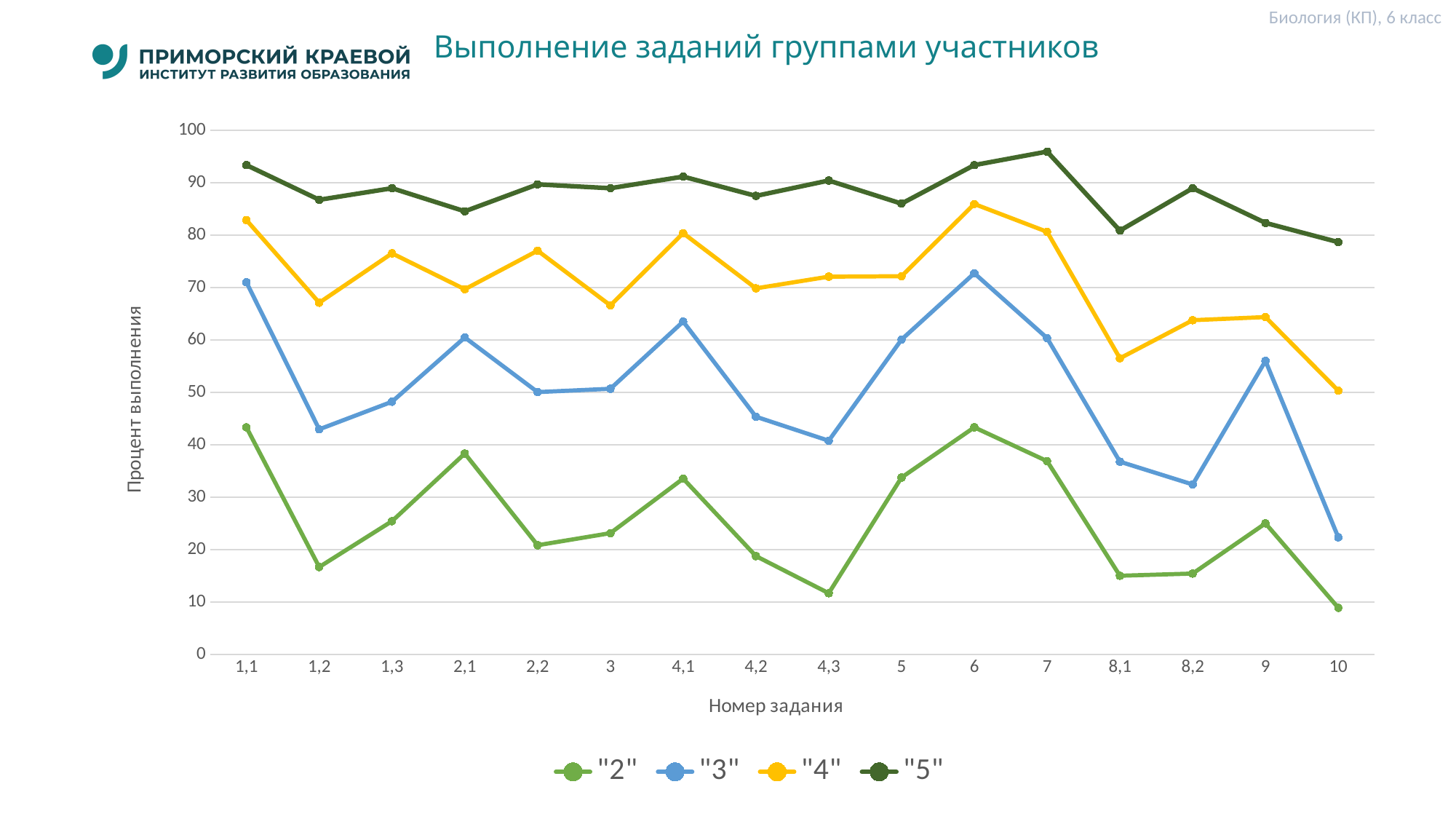
Does the series "5" rise or fall overall from task 7 to task 10? fall How many task numbers are shown along the x axis? 16 For series "4", which task has the larger value: 6 or 7? 6 Is the value of series "2" for task 4,3 greater or less than 20? less How many series does the legend list? 4 For which task number does the series "4" reach its highest value? 6 Is the value of series "5" for task 7 greater or less than 90? greater Is the value of series "3" for task 4,3 greater or less than 50? less What is the label of the y axis? Процент выполнения What kind of chart is shown on the slide? line chart For which task number does the series "2" have its lowest value? 10 For which task number does the series "5" reach its highest value? 7